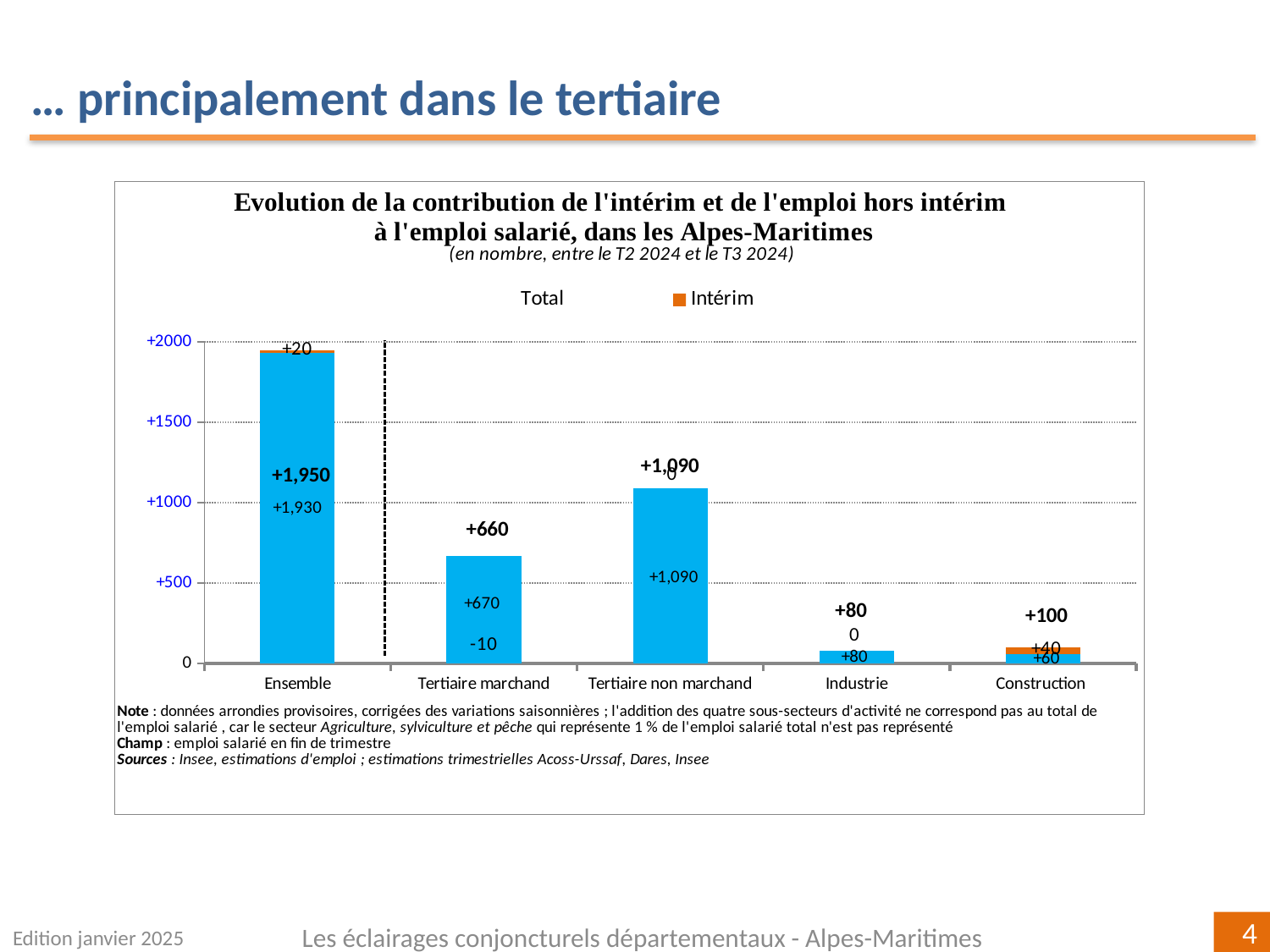
What is the total value shown for Ensemble? +1,950 What is the difference between the total values for Tertiaire non marchand and Tertiaire marchand? 430 What is the Intérim value shown for Tertiaire marchand? -10 What is the Intérim value shown for Ensemble? +20 Which category has the lowest total value? Industrie Which has a larger total value, Industrie or Construction? Construction What is the Intérim value shown for Construction? +40 Which category has the highest total value? Ensemble How many categories are shown on the x axis? 5 What is the total value shown for Tertiaire non marchand? +1,090 What kind of chart is shown on the slide? Bar chart Which period does the chart subtitle say the data covers? Entre le T2 2024 et le T3 2024